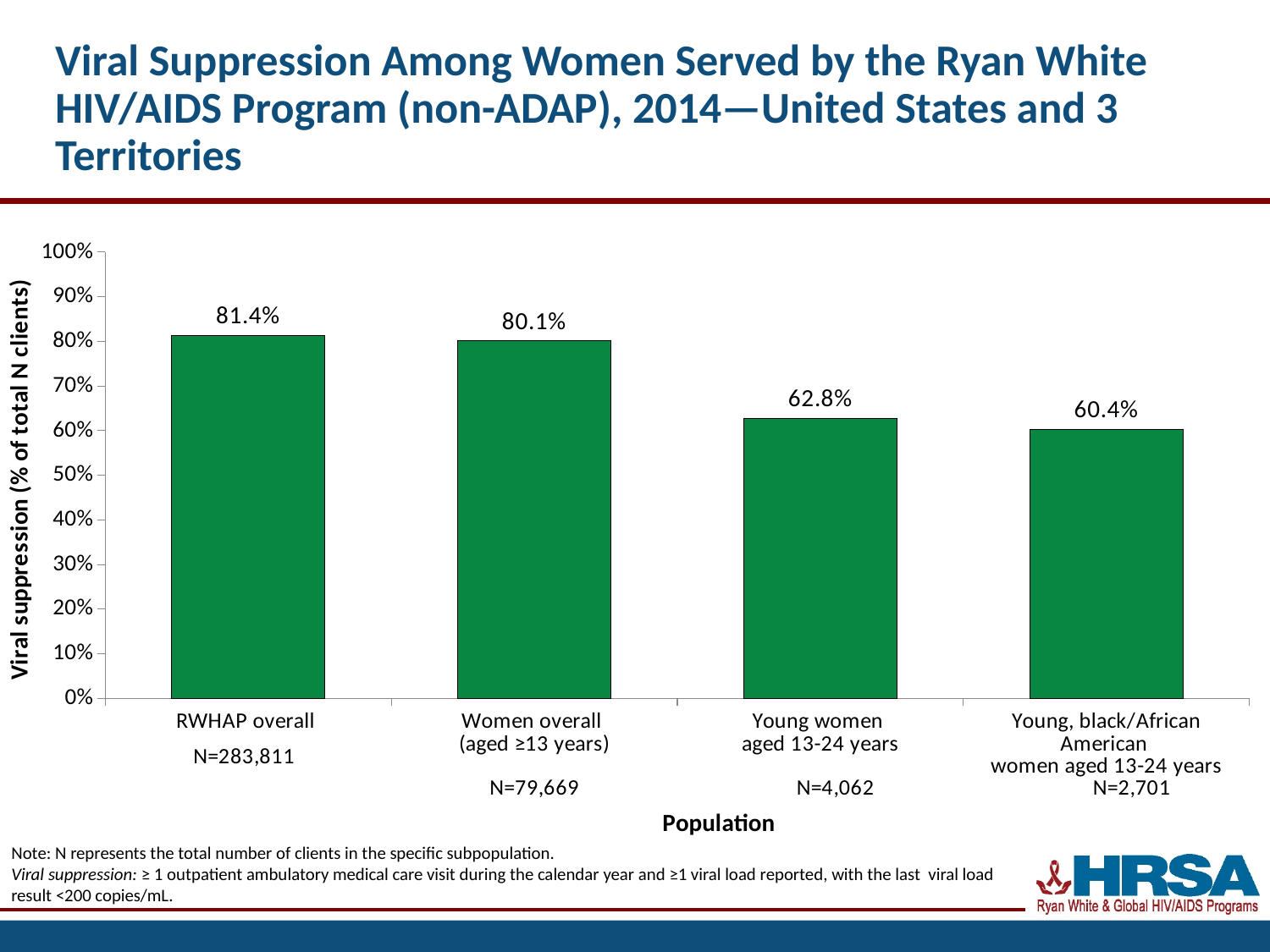
Which population has the highest viral suppression percentage? RWHAP overall What is the label of the y axis? Viral suppression (% of total N clients) What is the difference in viral suppression between RWHAP overall and Young women aged 13-24 years? 18.6% What is the difference in viral suppression between Women overall (aged ≥13 years) and Young, black/African American women aged 13-24 years? 19.7% Which has a higher viral suppression percentage: Women overall (aged ≥13 years) or Young women aged 13-24 years? Women overall (aged ≥13 years) What is the viral suppression percentage for Young, black/African American women aged 13-24 years? 60.4% Which population has the lowest viral suppression percentage? Young, black/African American women aged 13-24 years What is the viral suppression percentage for RWHAP overall? 81.4% What kind of chart is shown on the slide? Bar chart What is the viral suppression percentage for Young women aged 13-24 years? 62.8% How many populations are shown on the chart? 4 What is the viral suppression percentage for Women overall (aged ≥13 years)? 80.1%